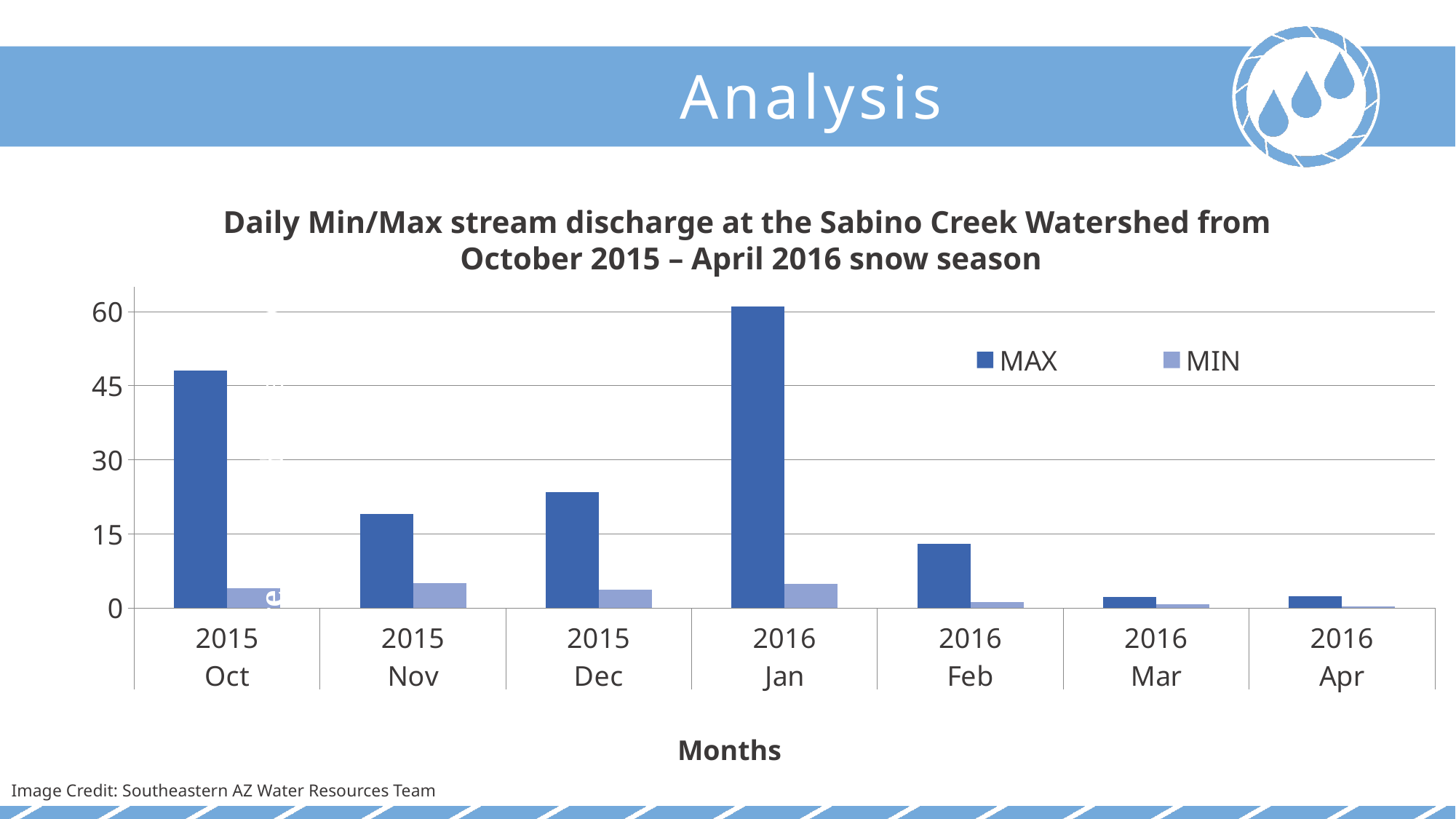
How many series does the legend list? 2 Which is larger, the MAX value for 2015 Oct or the MAX value for 2015 Dec? 2015 Oct What kind of chart is shown on the slide? bar chart Is the MAX value for 2016 Feb greater or less than 15? less What is the title of the x axis? Months Is the MAX value for 2016 Jan greater or less than 45? greater Which is larger, the MAX value for 2015 Nov or the MAX value for 2015 Dec? 2015 Dec How many months are shown on the x axis? 7 Which month has the highest MAX stream discharge? 2016 Jan Is the MAX value for 2015 Nov greater or less than 15? greater Do the MAX values rise or fall from 2016 Jan to 2016 Apr? fall